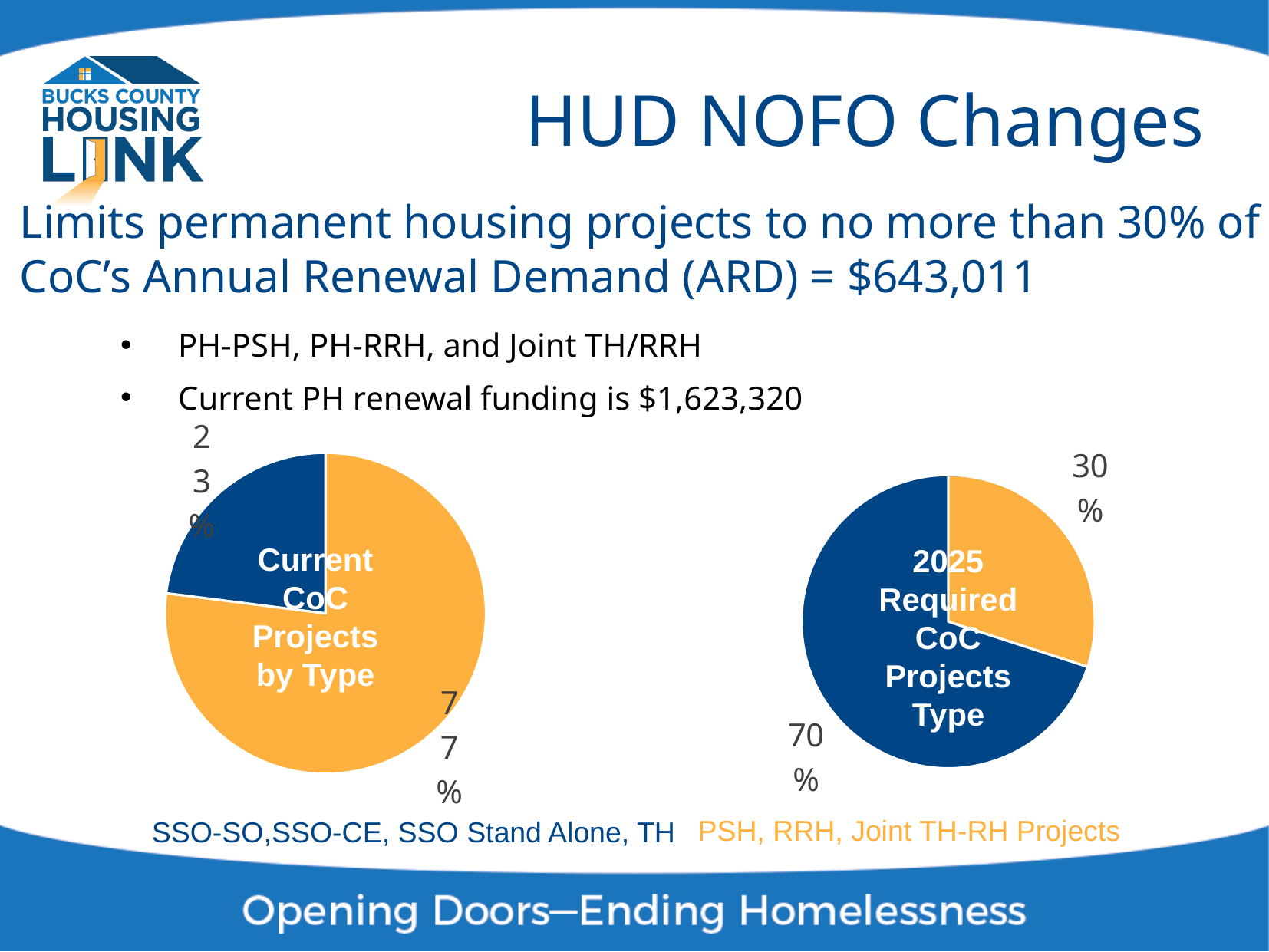
In the "2025 Required CoC Projects Type" chart, what share is shown for the blue slice (SSO-SO, SSO-CE, SSO Stand Alone, TH)? 70% In the "Current CoC Projects by Type" chart, what is the difference between the orange slice and the blue slice? 54% In the "2025 Required CoC Projects Type" chart, which slice is the largest? SSO-SO, SSO-CE, SSO Stand Alone, TH (70%) In the "Current CoC Projects by Type" chart, what share is shown for the blue slice (SSO-SO, SSO-CE, SSO Stand Alone, TH)? 23% What is the difference between the PSH, RRH, Joint TH-RH share in the "Current CoC Projects by Type" chart and in the "2025 Required CoC Projects Type" chart? 47% In the "2025 Required CoC Projects Type" chart, what share is shown for the orange slice (PSH, RRH, Joint TH-RH Projects)? 30% What kind of chart is the "Current CoC Projects by Type" chart? Pie chart Which colour represents PSH, RRH, Joint TH-RH Projects in the pie charts? Orange In the "Current CoC Projects by Type" chart, which slice is larger, the orange one or the blue one? Orange In the "Current CoC Projects by Type" chart, which slice is the smallest? SSO-SO, SSO-CE, SSO Stand Alone, TH (23%) How many slices does the "2025 Required CoC Projects Type" pie chart have? 2